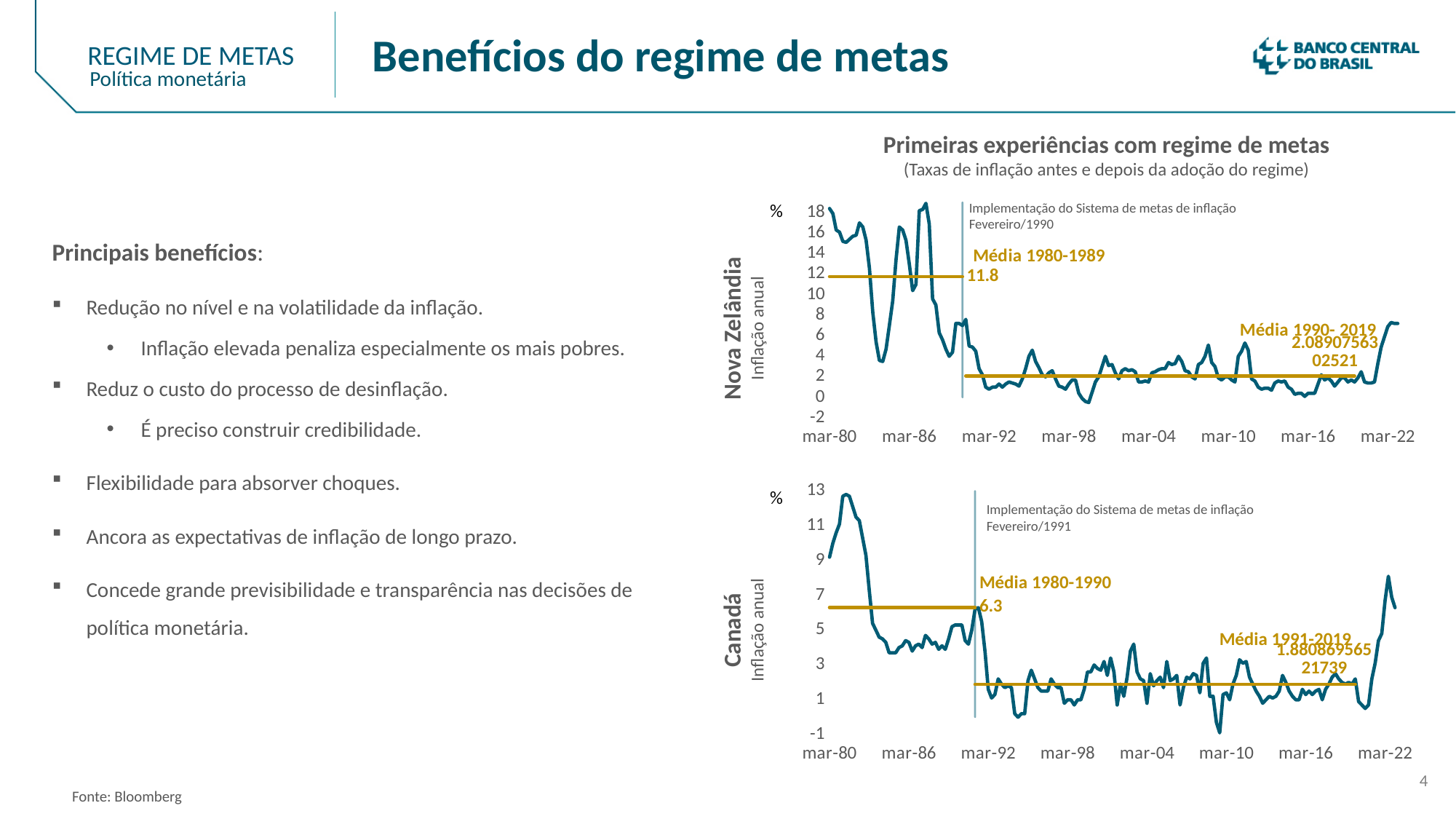
In the Canadá chart, is the inflation value at mar-22 greater or less than 5? greater What is the difference between the Nova Zelândia Média 1980-1989 (11.8) and the Canadá Média 1980-1990 (6.3)? 5.5 In the Canadá chart, is the inflation value at mar-80 greater or less than 7? greater In the Nova Zelândia chart, does inflation rise or fall between mar-80 and mar-92? fall According to the Canadá chart, when was the inflation targeting system implemented? Fevereiro/1991 In the Nova Zelândia chart, is the inflation value at mar-80 greater or less than 14? greater In the Canadá chart, what is the value of the Média 1980-1990? 6.3 Which is larger: the Nova Zelândia Média 1980-1989 or the Canadá Média 1980-1990? Nova Zelândia Média 1980-1989 According to the Nova Zelândia chart, when was the inflation targeting system implemented? Fevereiro/1990 How many charts are shown on the slide? 2 In the Nova Zelândia chart, what is the value of the Média 1980-1989? 11.8 What kind of chart is used for the Nova Zelândia panel? line chart